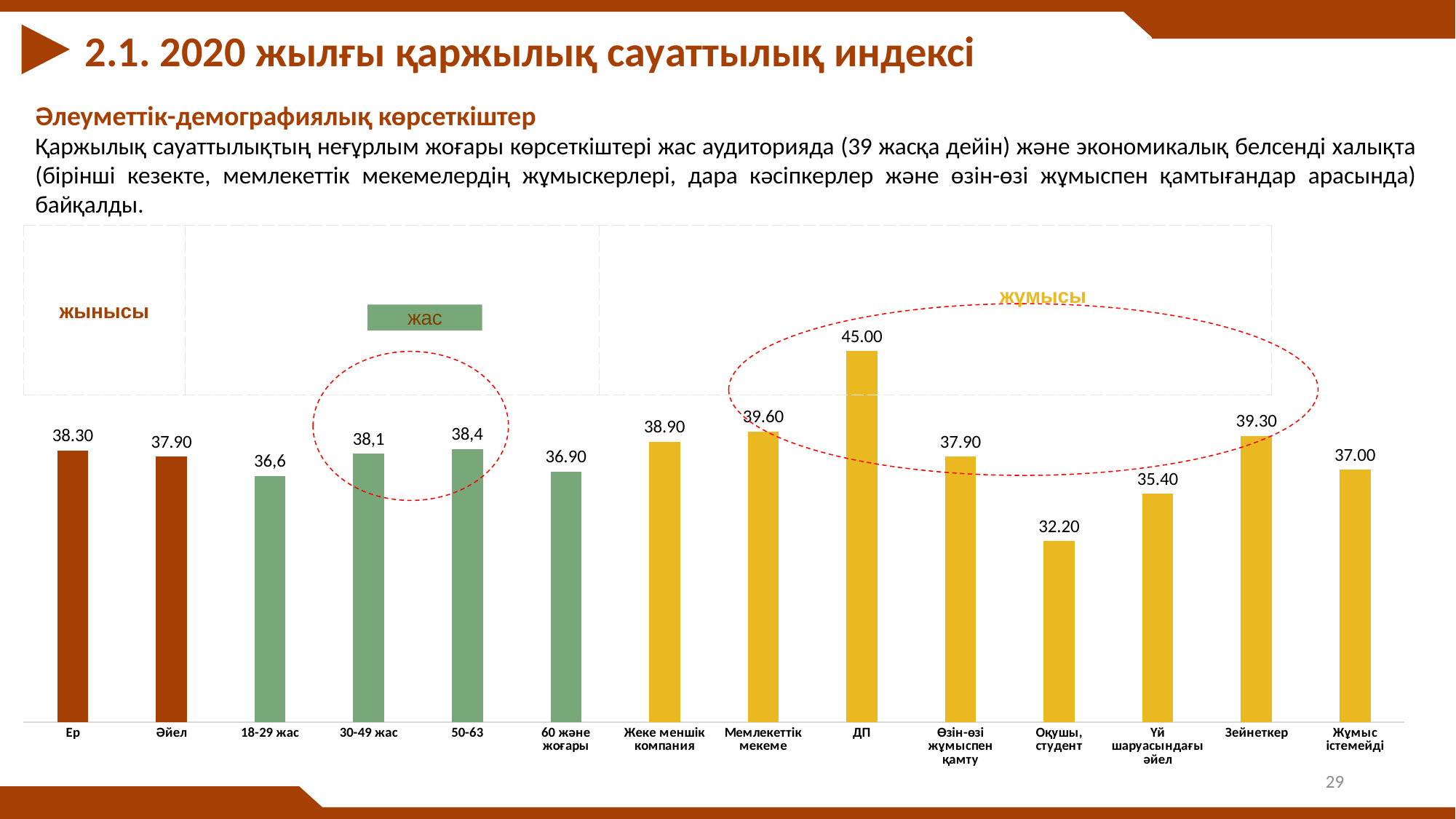
What is the value for Ер? 38.30 What is the value for Оқушы, студент? 32.20 Which category has the highest value? ДП What is the difference between the values for ДП and Оқушы, студент? 12.80 What is the value for Зейнеткер? 39.30 What is the difference between the values for Ер and Әйел? 0.40 What kind of chart is shown on the slide? Bar chart How many categories are shown on the x axis? 14 What is the value for the 18-29 жас category? 36,6 Which is larger, the value for Мемлекеттік мекеме or the value for Жеке меншік компания? Мемлекеттік мекеме What is the value for ДП? 45.00 Which category has the lowest value? Оқушы, студент